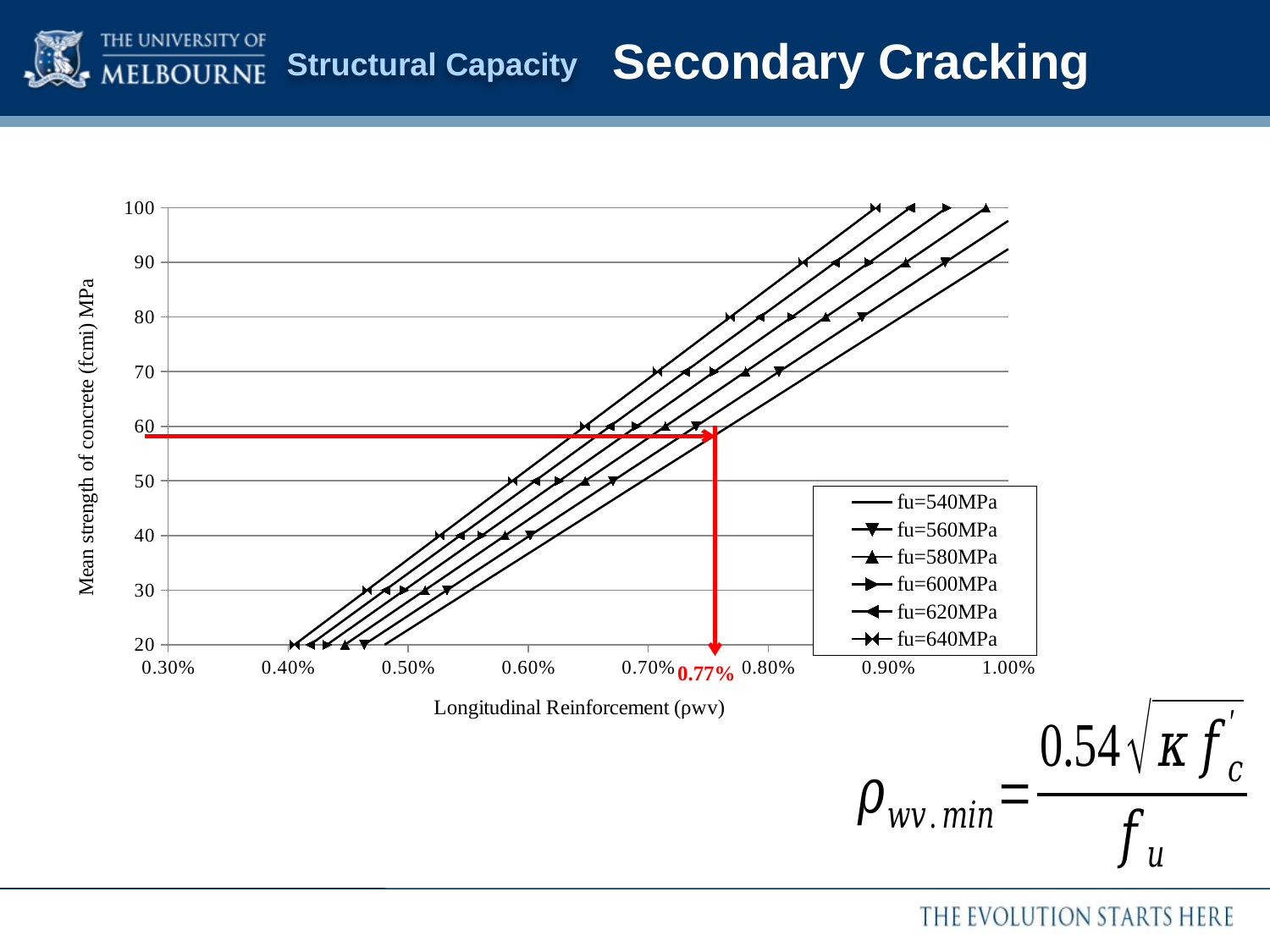
What is the label of the x axis of the chart? Longitudinal Reinforcement (ρwv) What is the label of the y axis of the chart? Mean strength of concrete (fcmi) MPa For the fu=640MPa series at 100 MPa, is the longitudinal reinforcement greater or less than 0.80%? greater What reinforcement value is marked in red on the x axis of the chart? 0.77% Which series in the chart lies furthest to the left (requires the least reinforcement at a given concrete strength)? fu=640MPa How many series does the chart legend list? 6 What is the highest value shown on the y axis of the chart? 100 Which series in the chart lies furthest to the right (requires the most reinforcement at a given concrete strength)? fu=540MPa Do the plotted lines rise or fall as the longitudinal reinforcement increases along the x axis? rise At a concrete strength of 60 MPa, which series requires more longitudinal reinforcement, fu=540MPa or fu=640MPa? fu=540MPa For the fu=640MPa series at 20 MPa, is the longitudinal reinforcement greater or less than 0.50%? less What kind of chart is shown on the slide? line chart